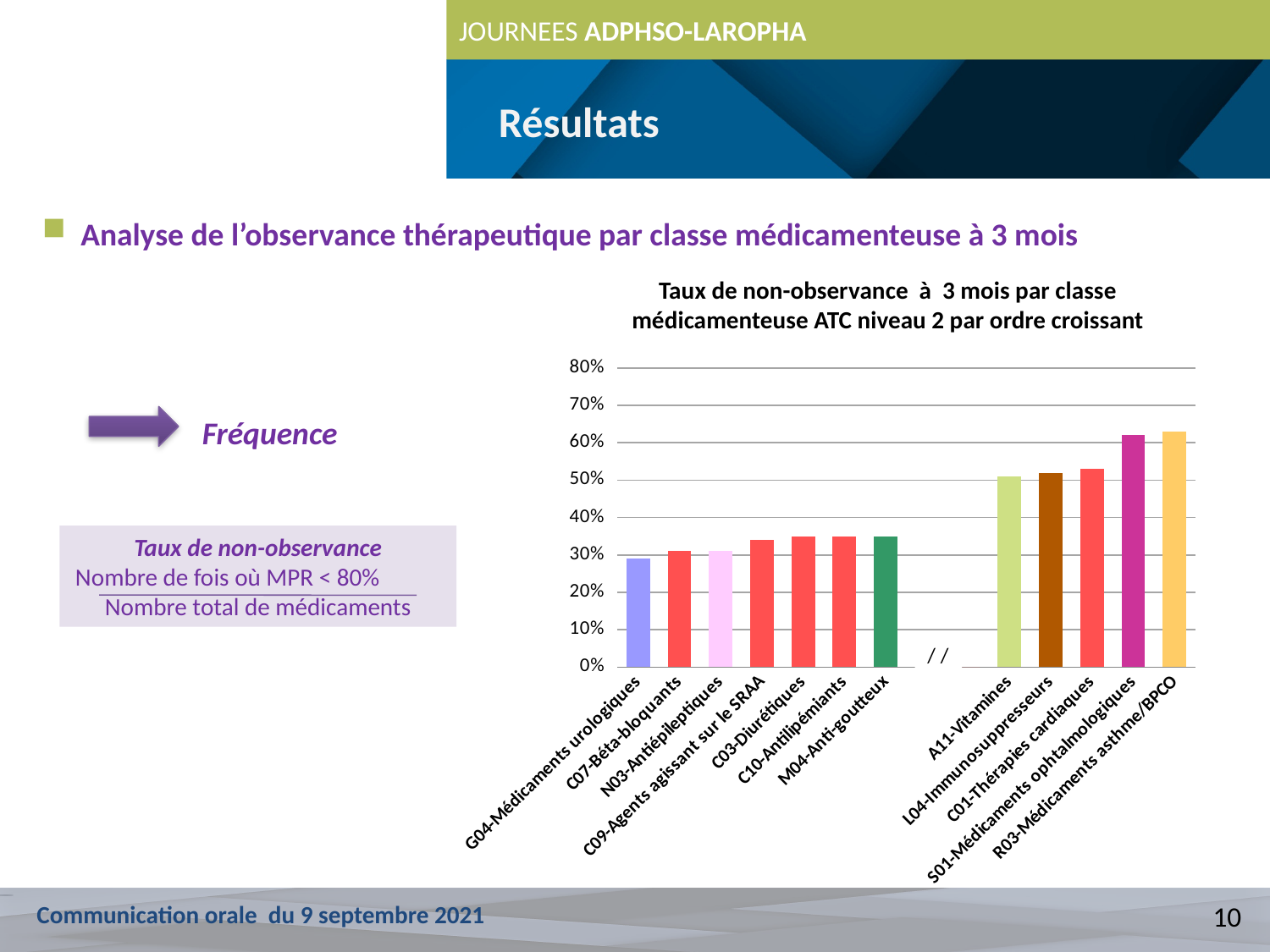
Is the value for A11-Vitamines greater or less than 40%? greater Is the value for S01-Médicaments ophtalmologiques greater or less than 60%? greater How many medication classes (bars) are plotted in the chart? 12 Do the values rise or fall from left to right along the x axis? rise What kind of chart is shown on the slide? bar chart Which medication class has the lowest non-observance rate in the chart? G04-Médicaments urologiques Is the value for G04-Médicaments urologiques greater or less than 40%? less Which has a higher non-observance rate, R03-Médicaments asthme/BPCO or G04-Médicaments urologiques? R03-Médicaments asthme/BPCO Which has a higher non-observance rate, A11-Vitamines or M04-Anti-goutteux? A11-Vitamines What is the title of the chart? Taux de non-observance à 3 mois par classe médicamenteuse ATC niveau 2 par ordre croissant